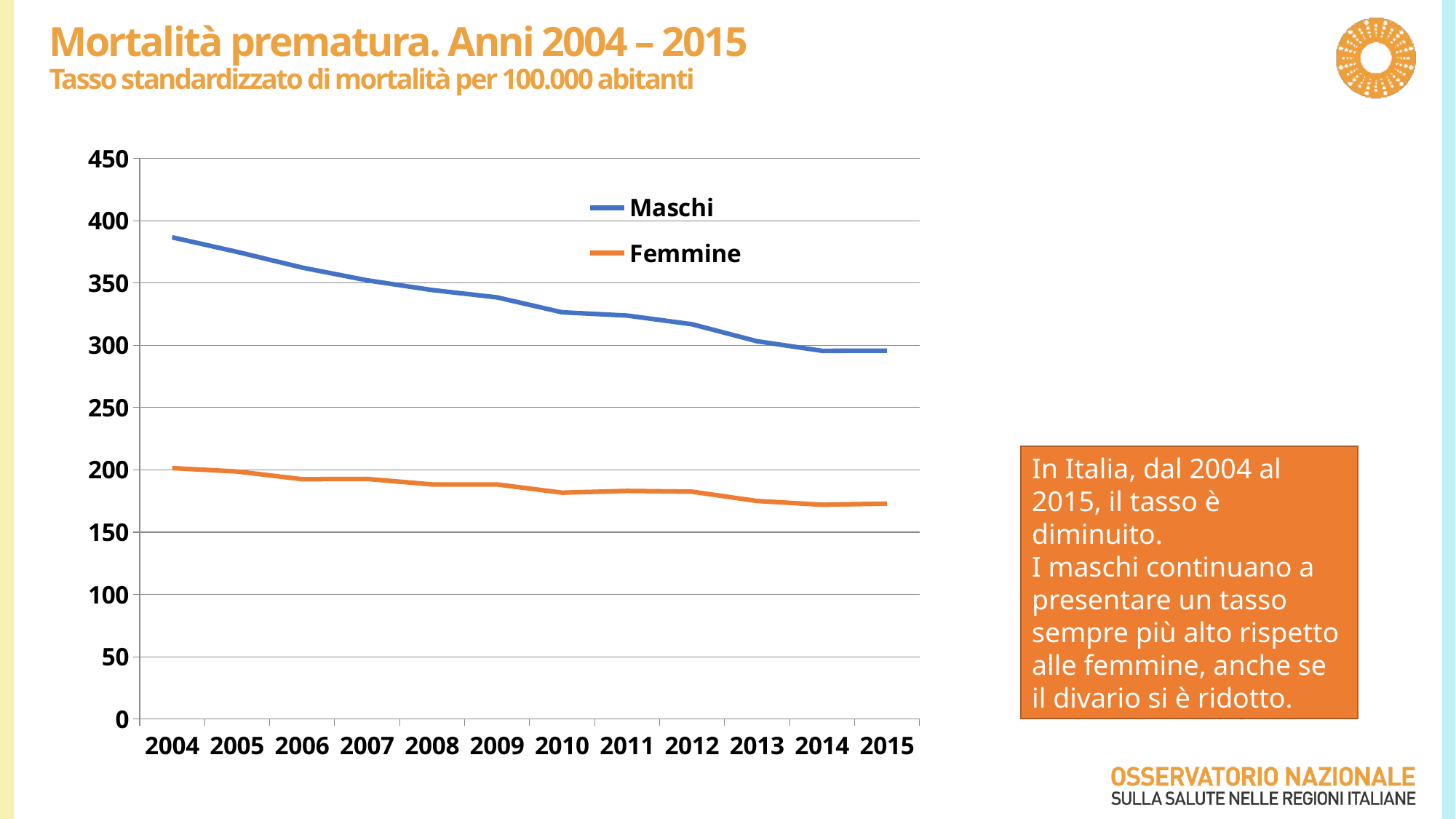
Is the value for Maschi in 2004 greater or less than 350? greater Is the value for Femmine in 2015 greater or less than 200? less What is the title of the slide? Mortalità prematura. Anni 2004 – 2015 Is the value for Maschi in 2012 greater or less than 300? greater Which series is drawn in orange? Femmine What kind of chart is shown on the slide? line chart Do the values for Maschi rise or fall from 2004 to 2015? fall In 2010, which series has the larger value, Maschi or Femmine? Maschi Do the values for Femmine rise or fall from 2004 to 2015? fall How many series does the legend list? 2 In which year is the value for Maschi highest? 2004 How many years are shown on the x axis? 12